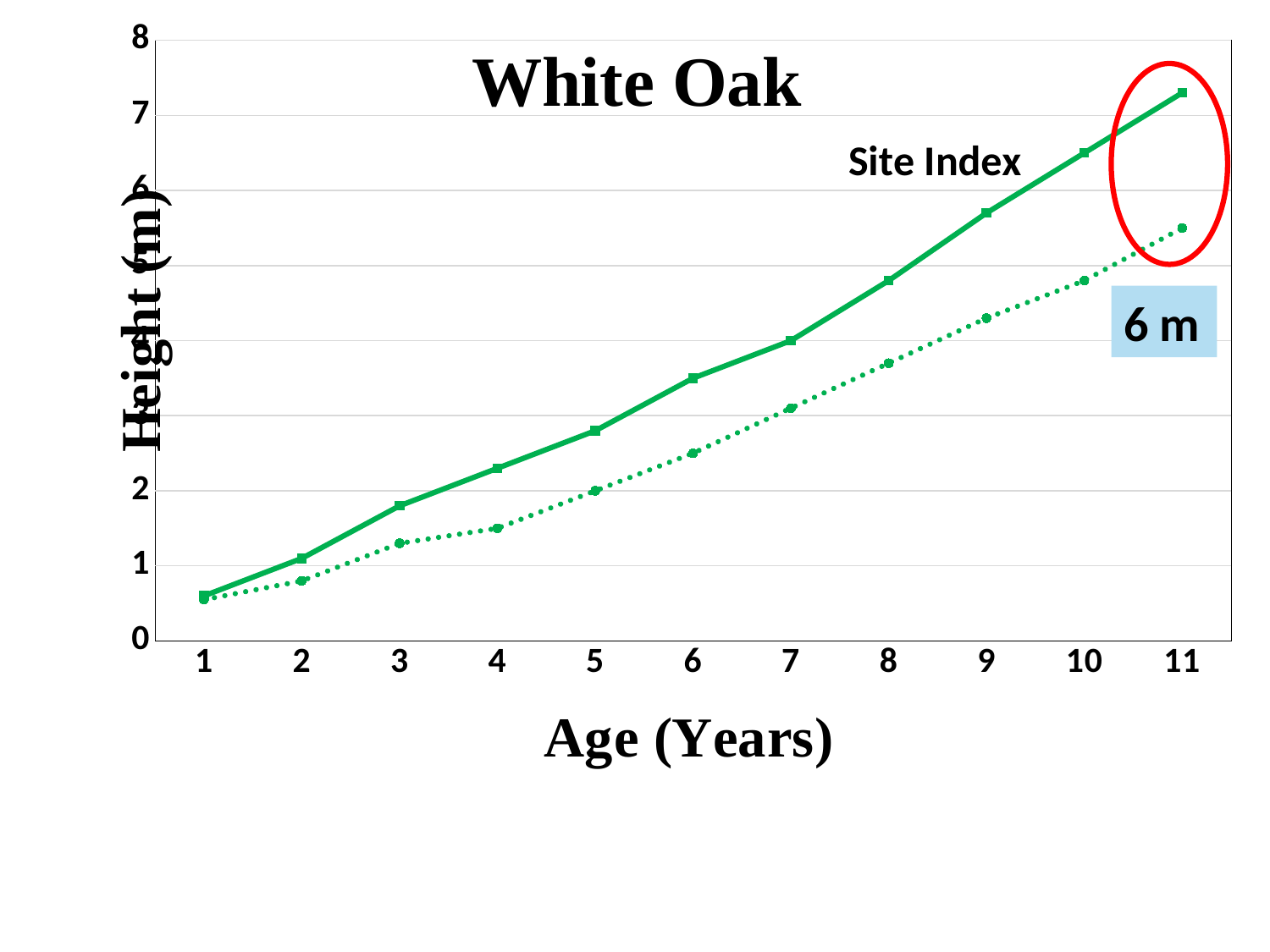
At which age does the solid line reach its highest height? 11 How many ages (points) are plotted along the x axis? 11 At age 11, which line has the larger height, the solid line or the dotted line? the solid line What kind of chart is shown on the slide? line chart Is the value of the solid line at age 6 greater or less than 3? greater Do the heights rise or fall as age increases? rise What is the label of the x axis? Age (Years) What is the title of the chart? White Oak Is the value of the solid line at age 9 greater or less than 5? greater At which age is the height of the dotted line lowest? 1 Is the value of the solid line at age 11 greater or less than 7? greater